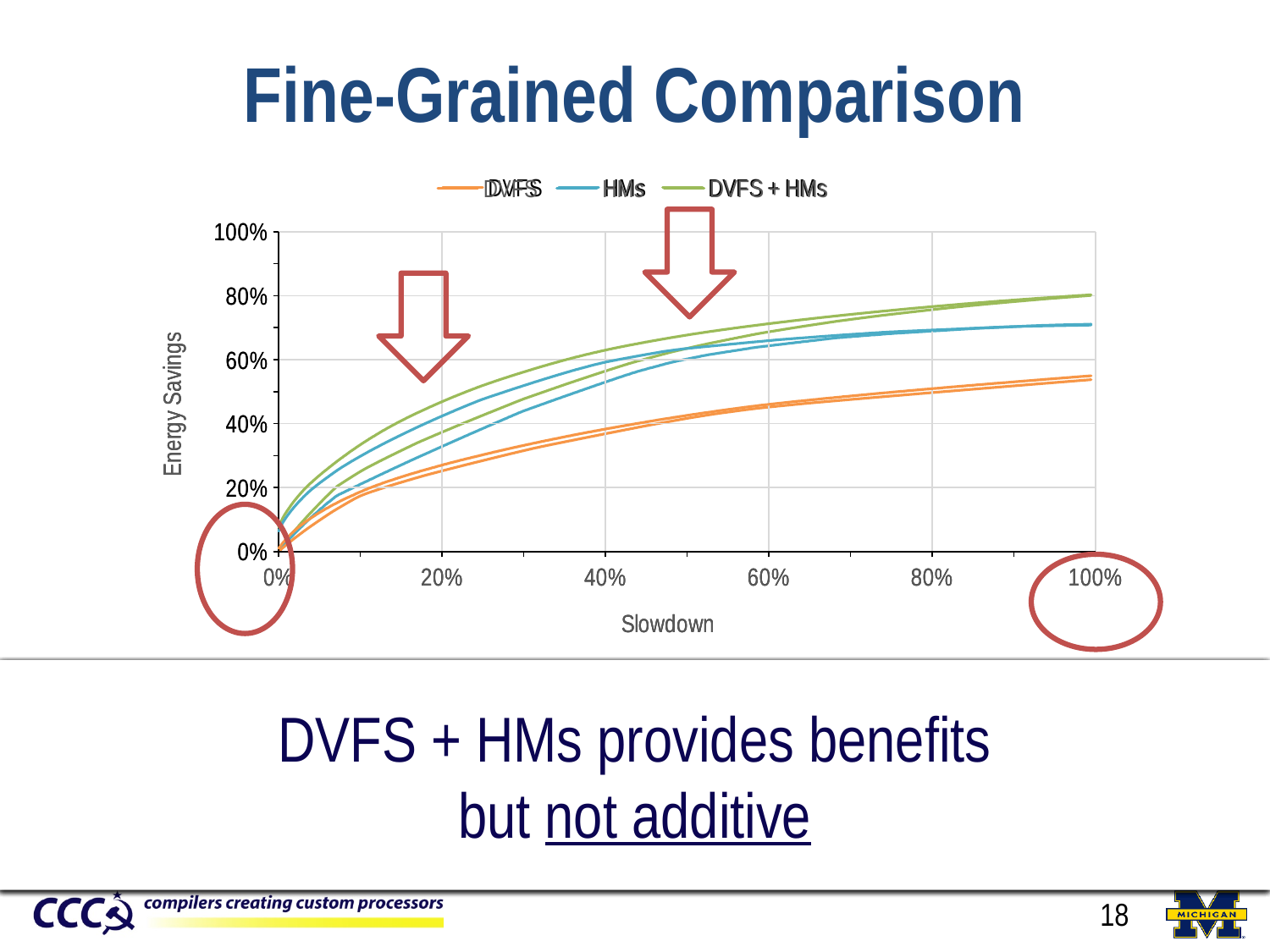
Do the energy savings rise or fall as slowdown increases along the x axis? Rise What is the title of the x axis? Slowdown At 100% slowdown, which series has higher energy savings, DVFS + HMs or HMs? DVFS + HMs At 100% slowdown, is the energy savings for DVFS greater or less than 40%? greater How many series does the legend list? 3 What kind of chart is shown on the slide? Line chart What are the series names listed in the legend? DVFS, HMs, DVFS + HMs Which series has the lowest energy savings at 100% slowdown? DVFS At 20% slowdown, is the energy savings for DVFS greater or less than 40%? less Which series reaches the highest energy savings at 100% slowdown? DVFS + HMs At 100% slowdown, is the energy savings for DVFS + HMs greater or less than 60%? greater At 40% slowdown, which series has higher energy savings, HMs or DVFS? HMs